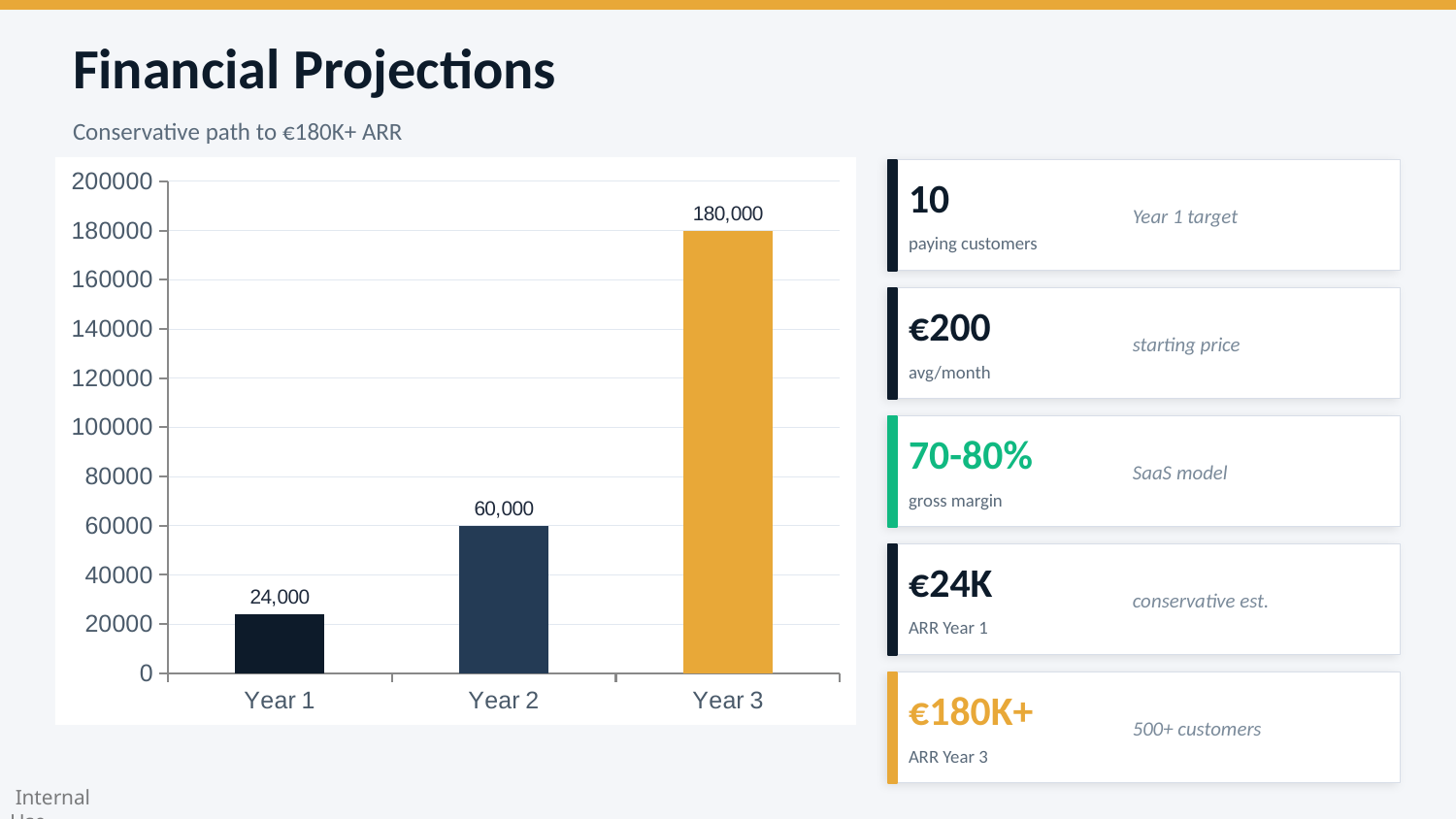
Which year has the highest value in the chart? Year 3 What is the value for Year 2 in the chart? 60,000 How many categories are shown on the x axis of the chart? 3 What is the difference between the Year 2 and Year 1 values? 36,000 Is the value for Year 2 greater or less than 80000? less Do the values rise or fall from Year 1 to Year 3? rise What is the value for Year 3 in the chart? 180,000 Which is larger, the value for Year 2 or the value for Year 1? Year 2 What is the value for Year 1 in the chart? 24,000 What is the difference between the Year 3 and Year 2 values? 120,000 Which year has the lowest value in the chart? Year 1 What kind of chart is shown on the slide? bar chart